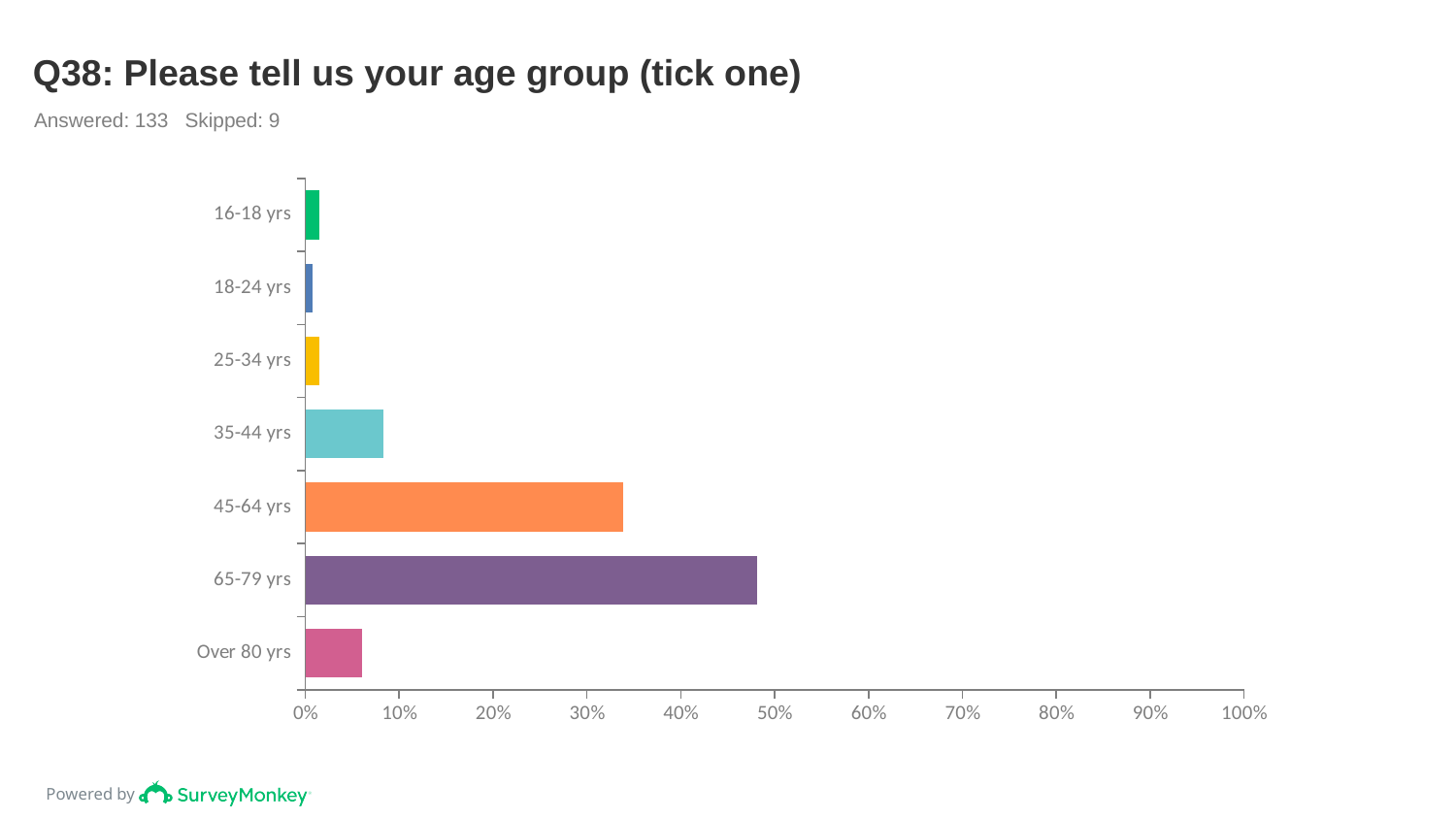
Is the value for 35-44 yrs greater or less than 10%? less What kind of chart is shown on the slide? bar chart What is the title of the chart? Q38: Please tell us your age group (tick one) Is the value for Over 80 yrs greater or less than 10%? less Is the value for 65-79 yrs greater or less than 40%? greater How many age group categories are plotted on the chart? 7 Which is larger, the value for 45-64 yrs or the value for 65-79 yrs? 65-79 yrs Which age group has the highest share of respondents? 65-79 yrs Which age group has the lowest share of respondents? 18-24 yrs Which is larger, the value for 35-44 yrs or the value for Over 80 yrs? 35-44 yrs